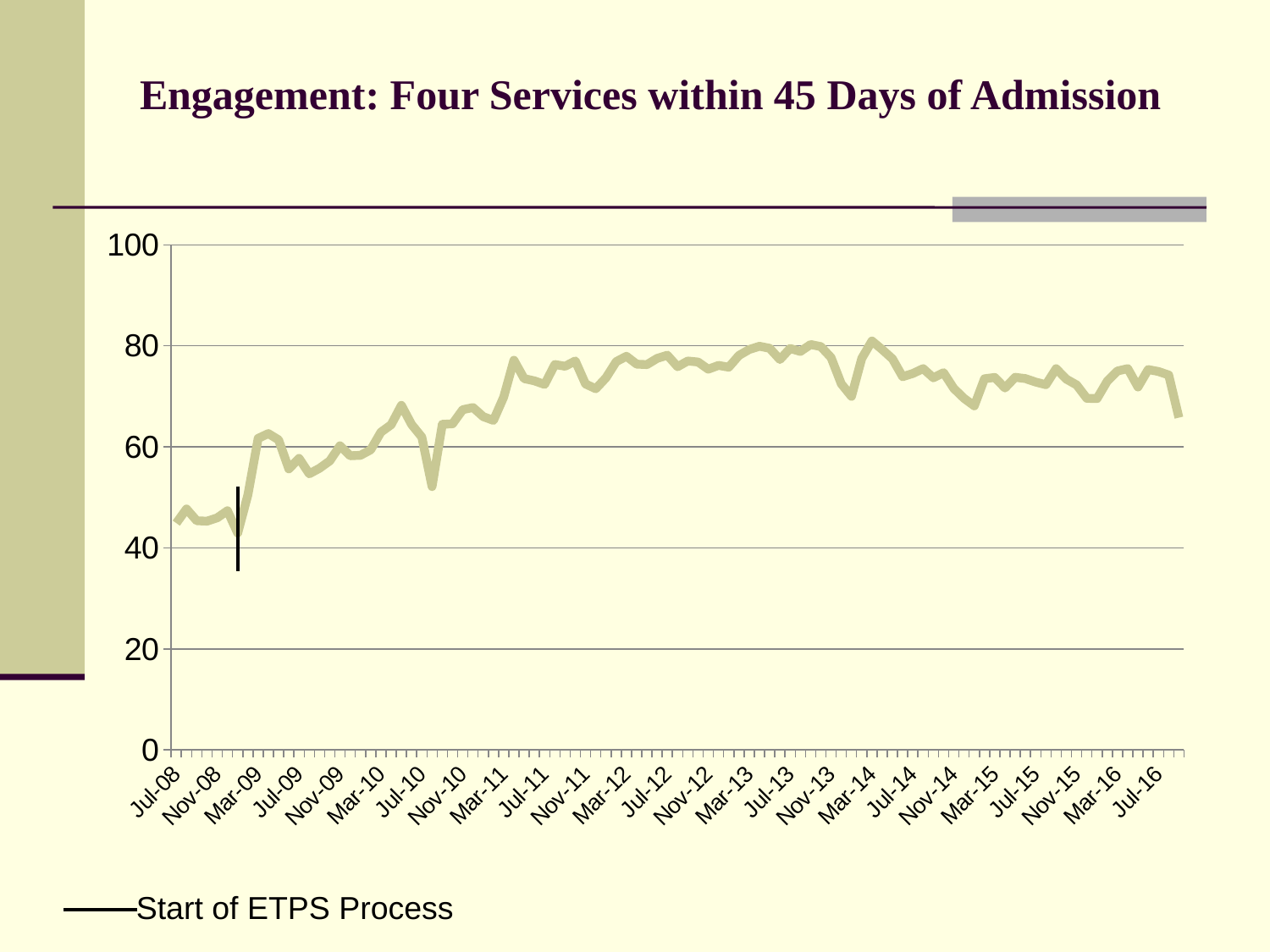
Is the value for Jul-08 greater or less than 40? greater Is the value for Jul-13 greater or less than 60? greater What entry does the legend below the chart list? Start of ETPS Process Is the value for Mar-13 greater or less than 100? less What is the title of the chart? Engagement: Four Services within 45 Days of Admission Does the line generally rise or fall from Jul-08 to Jul-13? rise Which is larger, the value for Nov-08 or the value for Jul-16? Jul-16 What kind of chart is shown on the slide? line chart Which is larger, the value for Jul-08 or the value for Jul-13? Jul-13